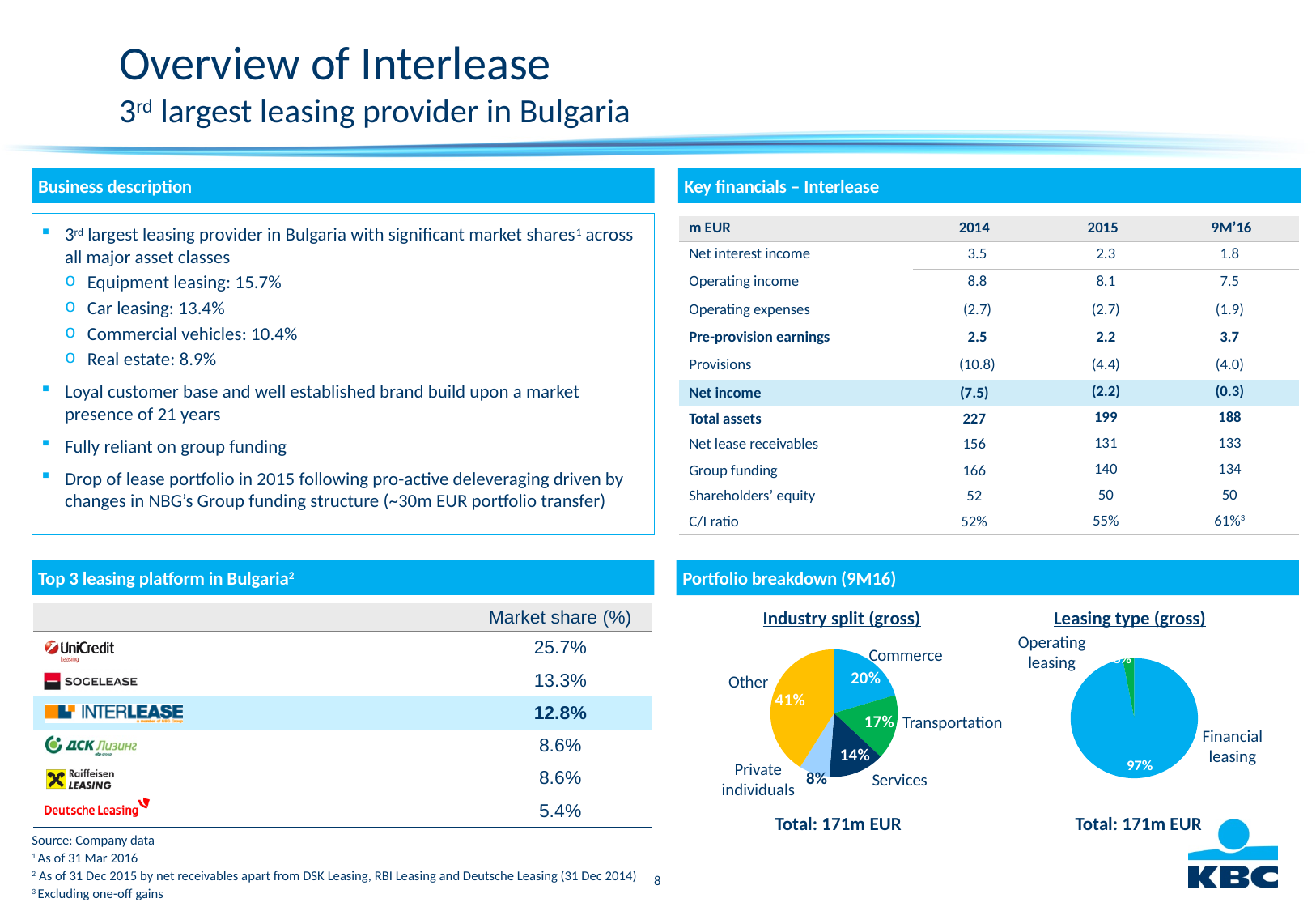
In the Industry split (gross) pie chart, what share does Transportation account for? 17% How many categories are shown in the Industry split (gross) pie chart? 5 In the Industry split (gross) pie chart, what share does Commerce account for? 20% In the Leasing type (gross) pie chart, what share does Financial leasing account for? 97% In the Industry split (gross) pie chart, which is larger: Commerce or Transportation? Commerce In the Industry split (gross) pie chart, what share do Private individuals account for? 8% In the Industry split (gross) pie chart, which category has the smallest share? Private individuals In the Leasing type (gross) pie chart, which category has the largest share? Financial leasing In the Industry split (gross) pie chart, which category has the largest share? Other What type of chart is used for the Leasing type (gross) breakdown? Pie chart What total amount is stated below the Industry split (gross) pie chart? Total: 171m EUR In the Industry split (gross) pie chart, what is the difference in percentage points between Other and Services? 27